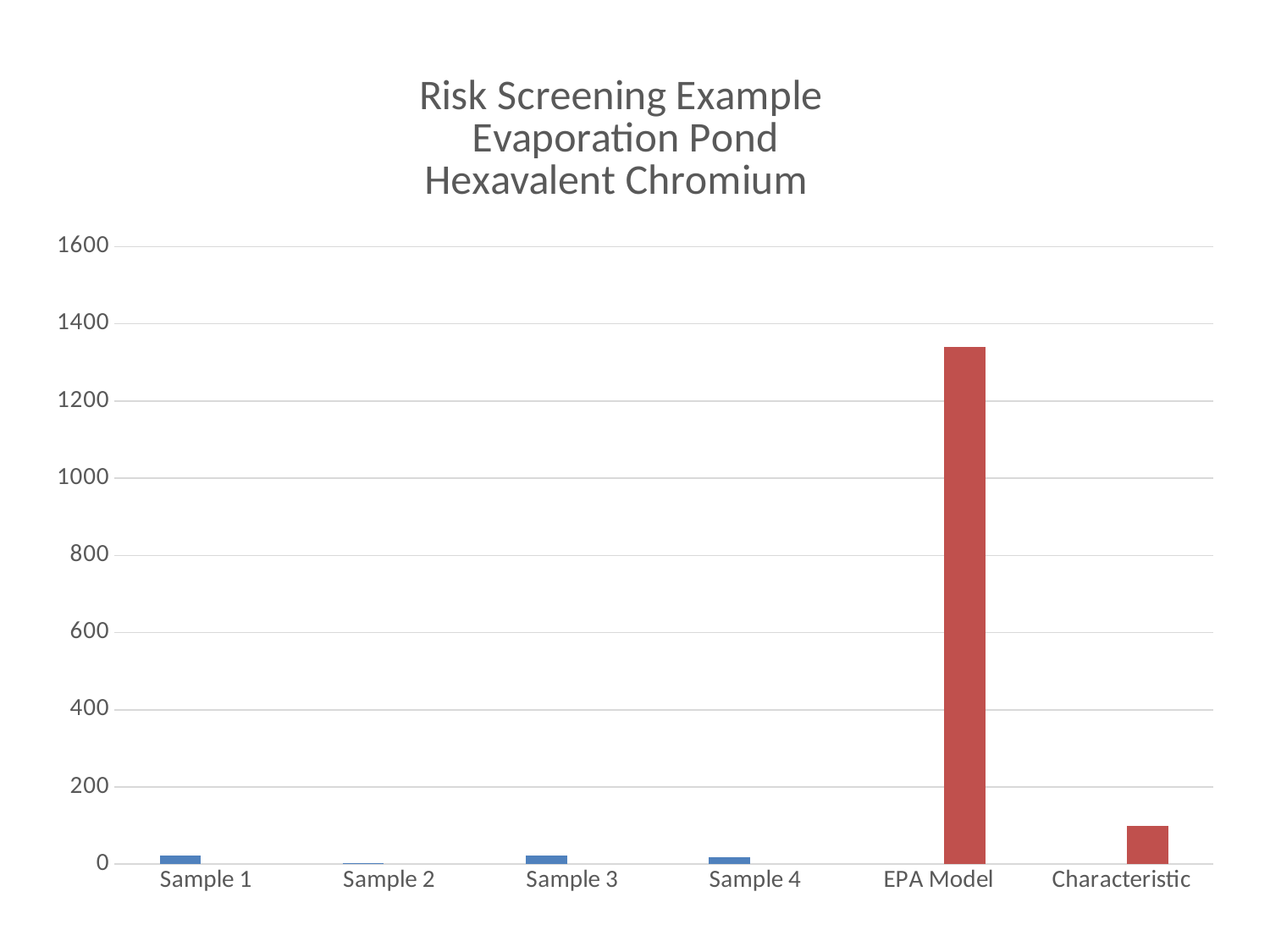
Is the value for Characteristic greater or less than 200? less Which is larger, the value for Sample 4 or the value for Sample 2? Sample 4 Is the value for EPA Model greater or less than 1200? greater Is the value for Sample 1 greater or less than 200? less What is the title of the chart? Risk Screening Example Evaporation Pond Hexavalent Chromium How many categories are shown on the x axis of the chart? 6 Which category has the highest value in the chart? EPA Model Which is larger, the value for EPA Model or the value for Characteristic? EPA Model What colour are the bars for EPA Model and Characteristic? red Which category has the lowest value in the chart? Sample 2 What kind of chart is shown on the slide? bar chart